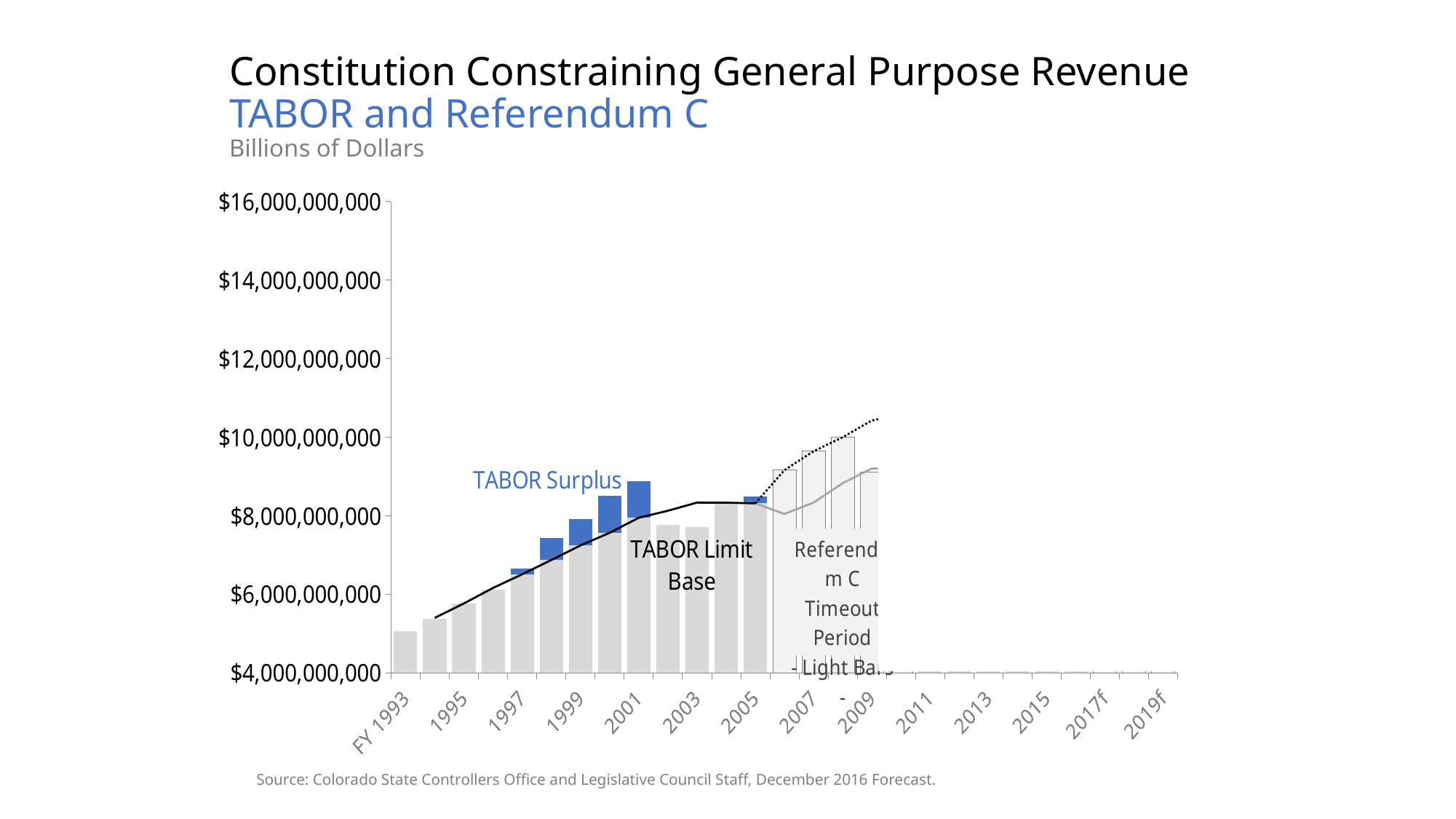
What is the unit of measurement stated under the chart title? Billions of Dollars Which is larger, the bar for 2001 or the bar for 2003? 2001 What do the blue portions of the bars represent, according to the label on the chart? TABOR Surplus Is the value for 1997 greater or less than $6,000,000,000? greater Do the bar values rise or fall from FY 1993 to 2001? rise Is the value for FY 1993 greater or less than $6,000,000,000? less Which year has the lowest bar on the chart? FY 1993 Is the value for 2001 greater or less than $8,000,000,000? greater What kind of chart is shown on the slide? Combination bar and line chart Which year has the highest bar on the chart? 2008